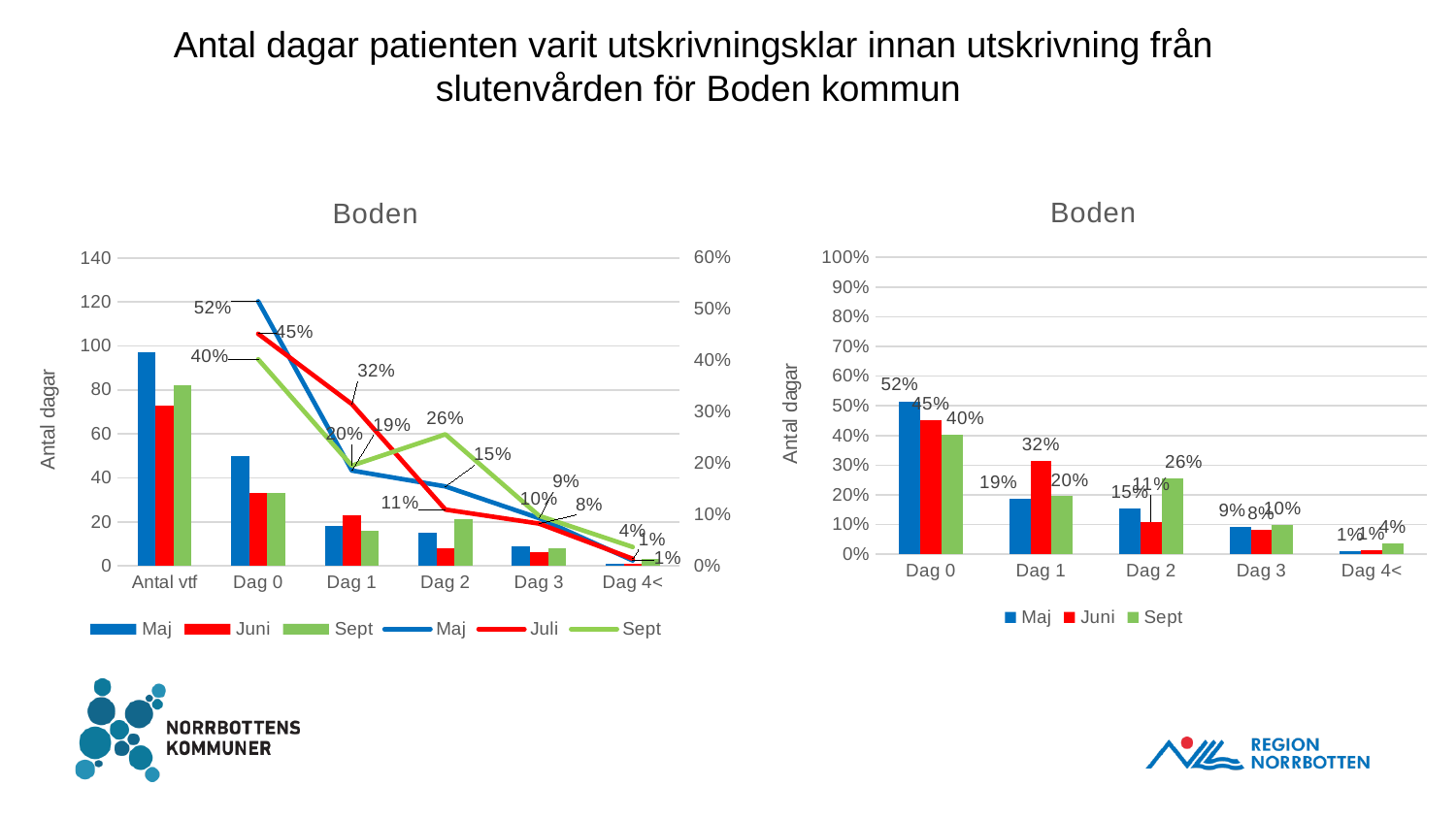
In the right-hand chart, which is larger at Dag 2: Maj or Sept? Sept What kind of chart is the right-hand chart? Bar chart In the left-hand chart, is the Juni bar for Dag 0 greater or less than 40? less In the right-hand chart, what is the value for Maj at Dag 0? 52% How many entries does the legend of the left-hand chart list? 6 In the left-hand chart, is the Maj bar for Antal vtf greater or less than 80? greater In the right-hand chart, what is the value for Sept at Dag 2? 26% In the right-hand chart, what is the value for Juni at Dag 1? 32% How many categories are shown on the x axis of the right-hand chart? 5 In the right-hand chart, what is the difference between Maj and Sept at Dag 0? 12% How many series does the legend of the right-hand chart list? 3 In the right-hand chart, which category has the highest value for Sept? Dag 0